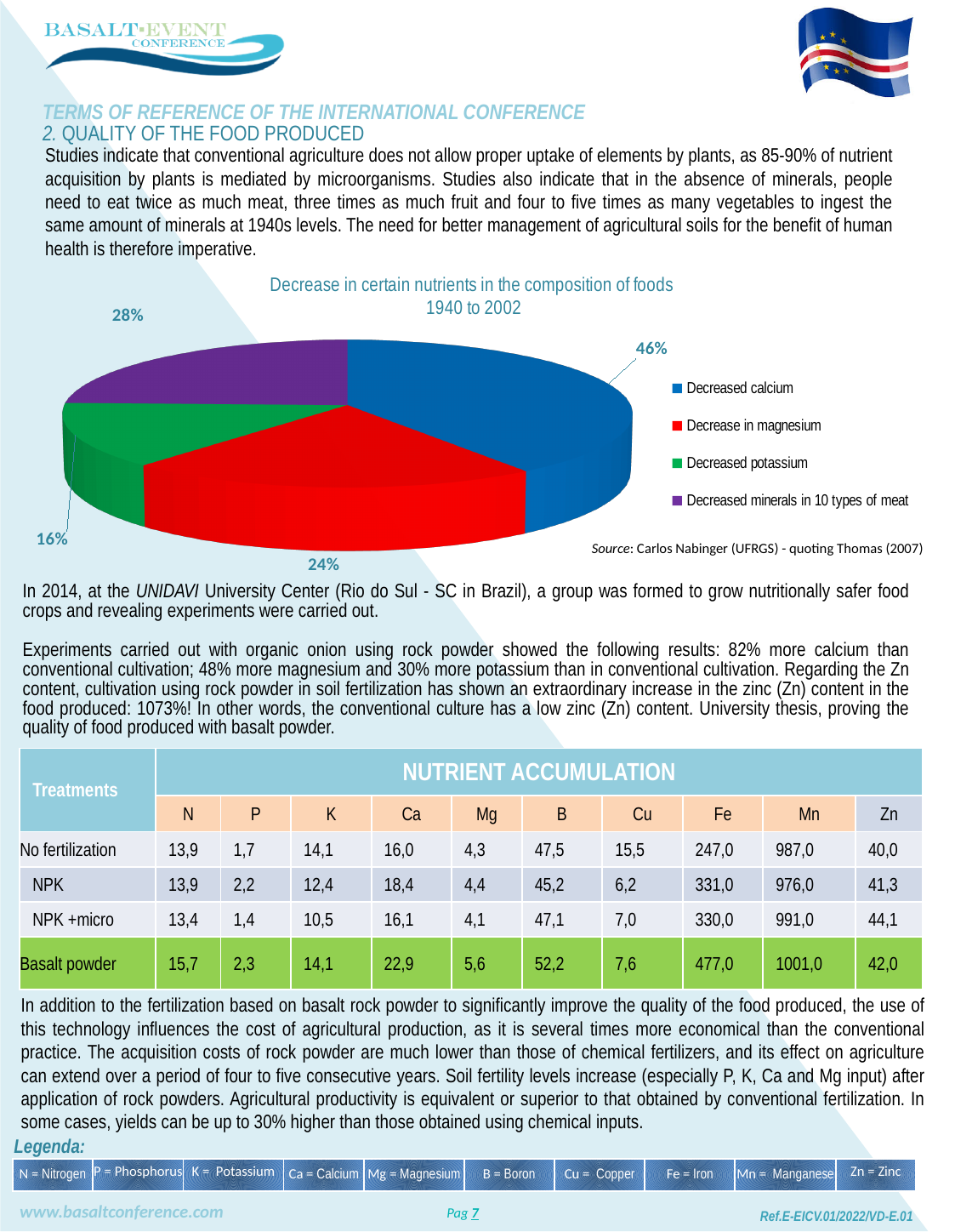
What is the difference in percentage points between Decreased calcium and Decrease in magnesium in the pie chart? 22 percentage points What is the title of the pie chart? Decrease in certain nutrients in the composition of foods 1940 to 2002 Which category has the largest slice in the pie chart? Decreased calcium What percentage is shown for Decreased potassium in the pie chart? 16% What percentage is shown for Decrease in magnesium in the pie chart? 24% Which category has the smallest slice in the pie chart? Decreased potassium What type of chart is shown on the slide? Pie chart How many entries does the legend of the pie chart list? 4 Which is larger in the pie chart: Decreased minerals in 10 types of meat or Decreased potassium? Decreased minerals in 10 types of meat What percentage is shown for Decreased minerals in 10 types of meat in the pie chart? 28% What colour is the Decreased potassium slice in the pie chart? Green What percentage is shown for Decreased calcium in the pie chart? 46%